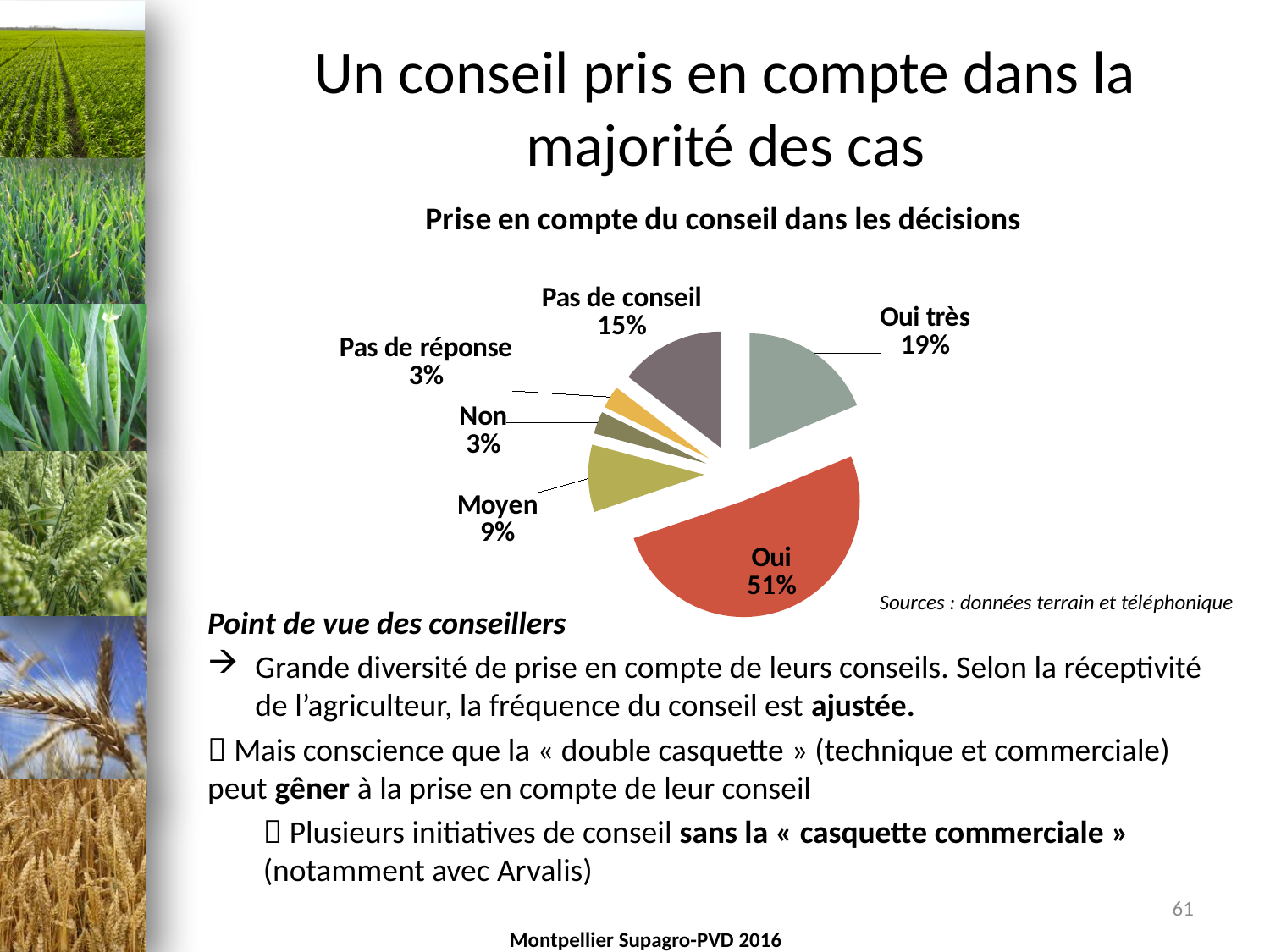
What is the difference between the "Oui" and "Oui très" values? 32% Which category has the largest slice of the pie? Oui How many slices does the pie chart have? 6 What type of chart is shown on the slide? Pie chart What is the value shown for "Pas de conseil"? 15% What is the title of the chart? Prise en compte du conseil dans les décisions What share of the pie does the "Oui" slice represent? 51% Which is larger, the "Pas de conseil" slice or the "Moyen" slice? Pas de conseil What is the value shown for "Moyen"? 9% What is the value shown for "Oui très"? 19% What is the combined share of "Oui" and "Oui très"? 70% What is the value shown for "Non"? 3%